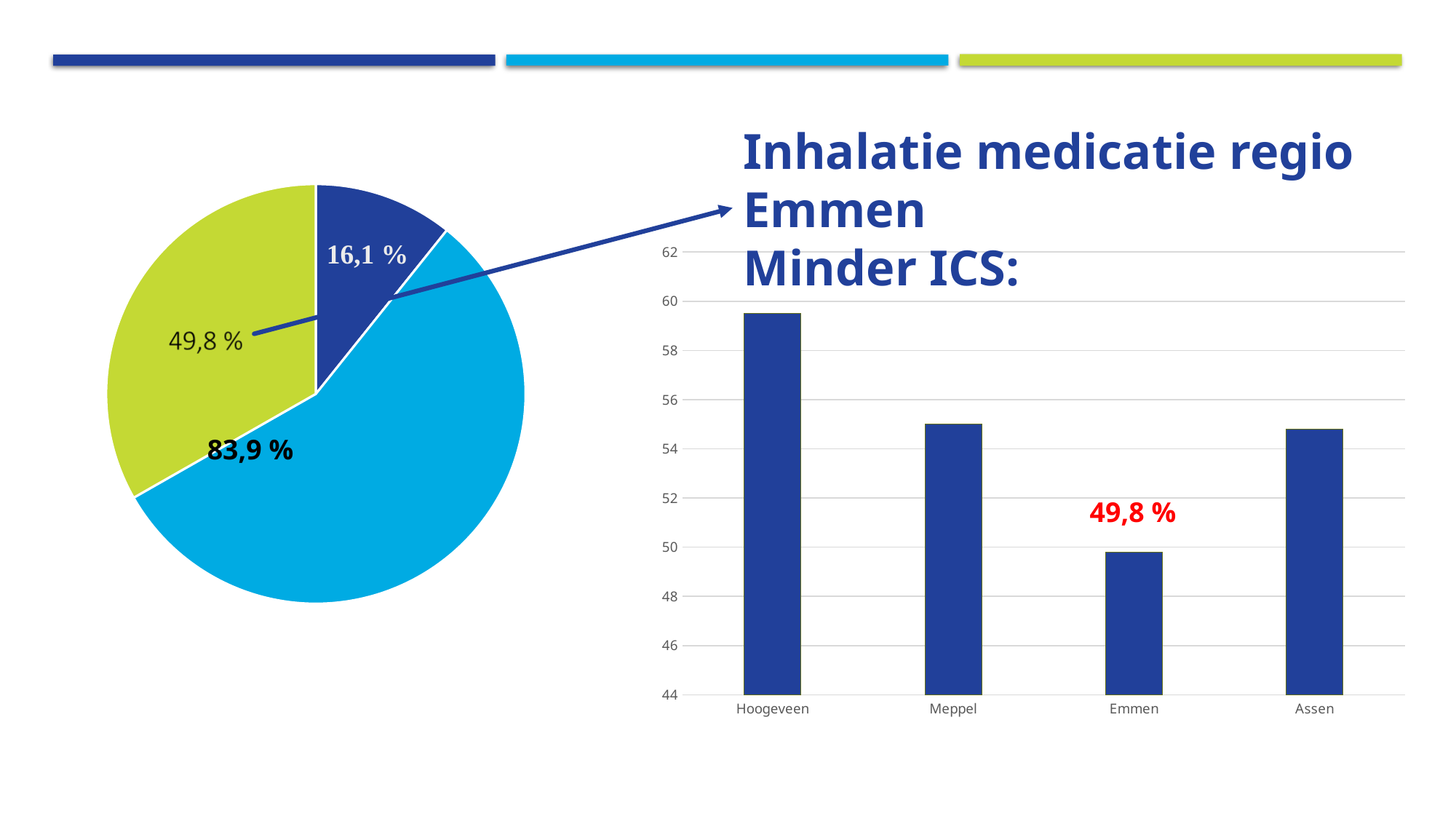
What is the title shown above the bar chart on the right? Inhalatie medicatie regio Emmen Minder ICS: In the bar chart on the right, how many categories are shown on the x axis? 4 In the pie chart on the left, what percentage is printed on the dark blue slice? 16,1 % In the bar chart on the right, which category has the lowest bar? Emmen What kind of chart is the chart on the right of the slide? bar chart In the bar chart on the right, is the value for Assen greater or less than 56? less In the bar chart on the right, is the value for Meppel greater or less than 54? greater In the bar chart on the right, which category has the highest bar? Hoogeveen What kind of chart is the chart on the left of the slide? pie chart In the bar chart on the right, which is larger, the value for Hoogeveen or the value for Emmen? Hoogeveen In the bar chart on the right, what value is printed for Emmen? 49,8 % In the bar chart on the right, is the value for Hoogeveen greater or less than 58? greater